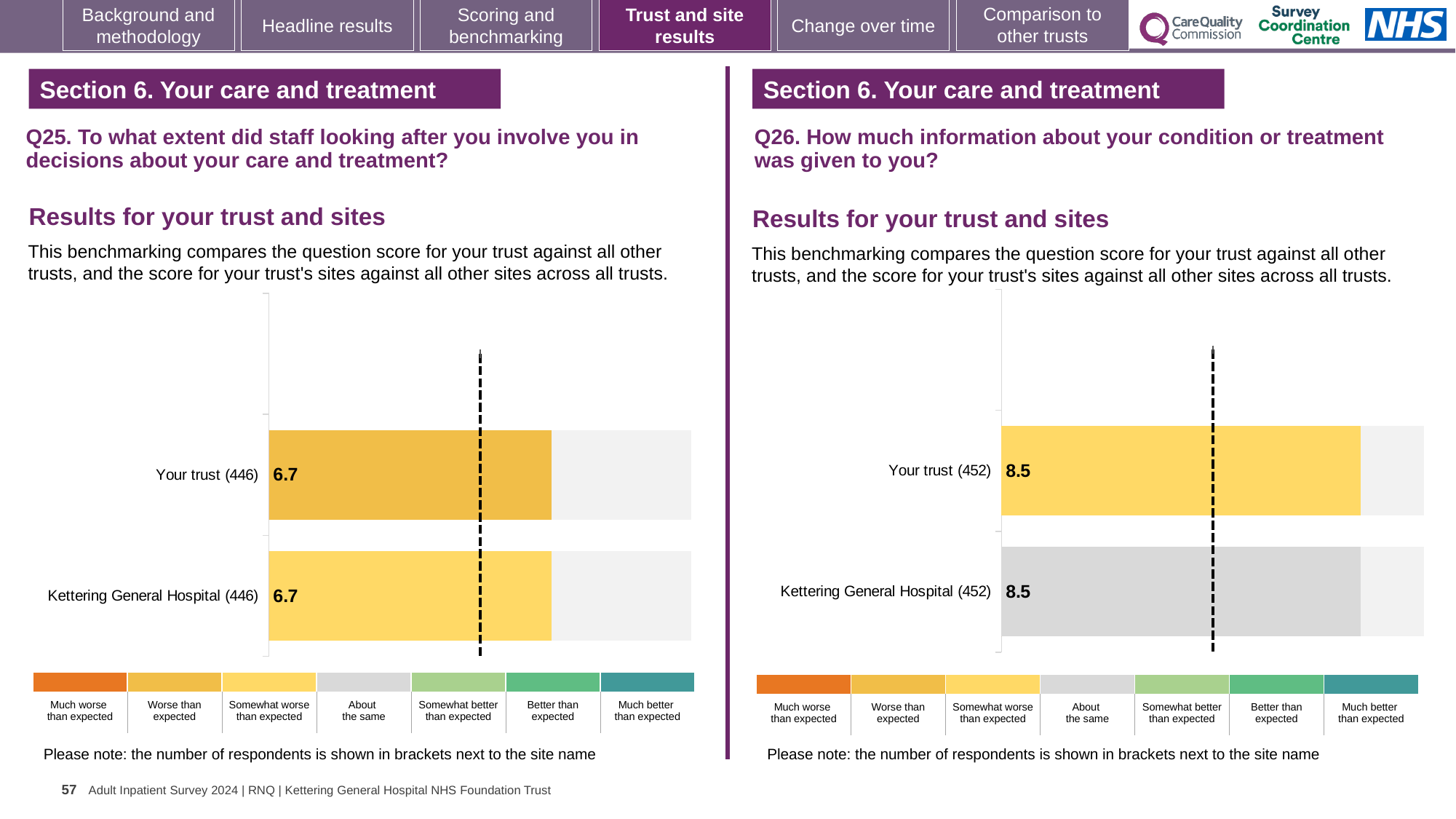
What kind of chart is the Q25 chart on the left? Bar chart In the Q25 chart on the left, what is the score for Kettering General Hospital? 6.7 How many benchmark categories are shown in the colour key below the Q26 chart on the right? 7 In the Q25 chart on the left, what is the difference between the score for Your trust and the score for Kettering General Hospital? 0 In the Q26 chart on the right, which benchmark category does the colour of the Kettering General Hospital bar correspond to? About the same In the Q25 chart on the left, what is the score for Your trust? 6.7 In the Q26 chart on the right, what is the score for Your trust? 8.5 In the Q25 chart on the left, which benchmark category does the colour of the Your trust bar correspond to? Worse than expected In the Q26 chart on the right, what is the score for Kettering General Hospital? 8.5 In the Q26 chart on the right, how many bars are plotted? 2 In the Q26 chart on the right, how many respondents are shown in brackets for Kettering General Hospital? 452 In the Q25 chart on the left, how many respondents are shown in brackets for Your trust? 446